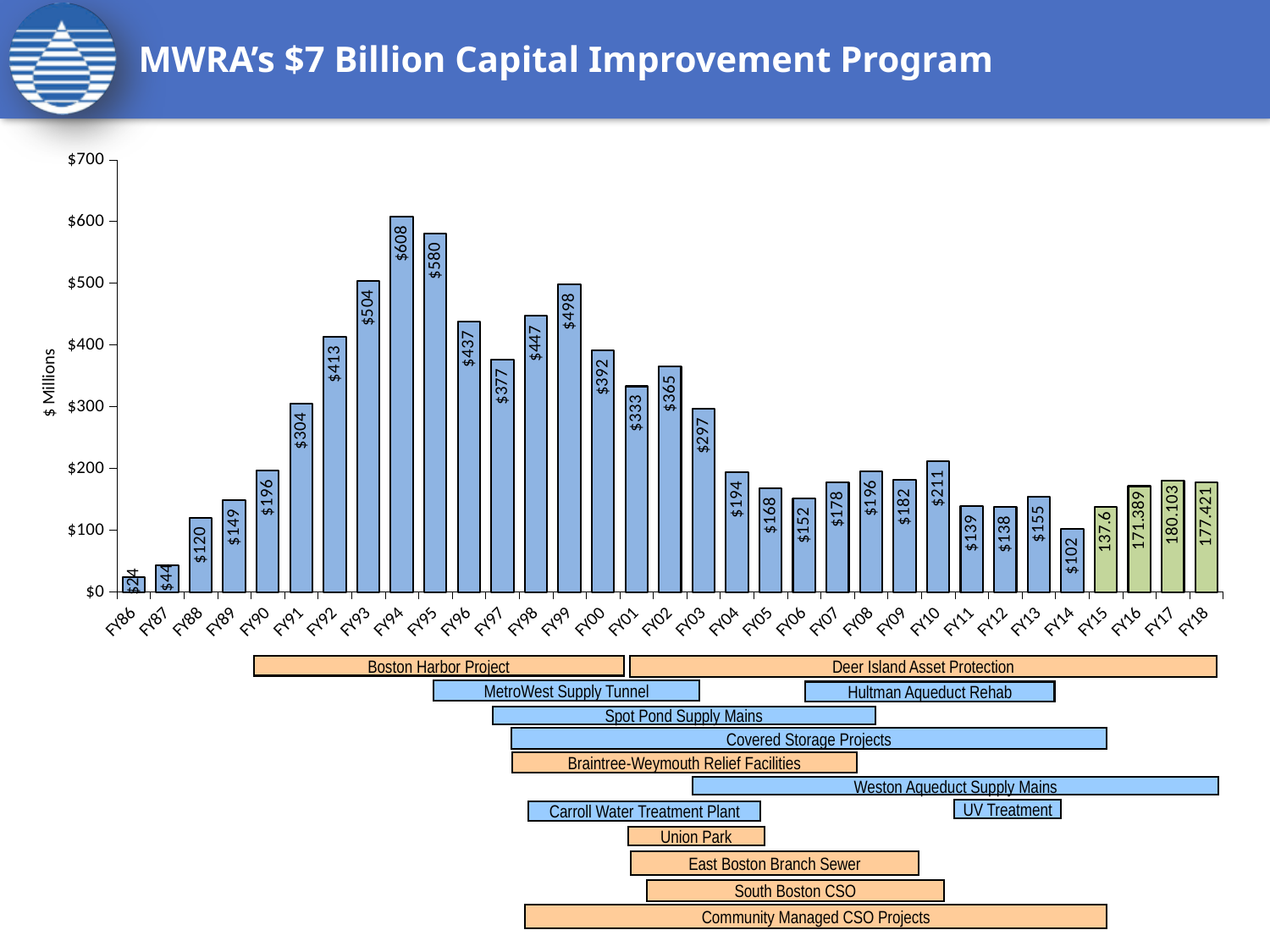
Which is larger, the value for FY02 or the value for FY01? FY02 What is the value for FY17? 180.103 Which fiscal year has the highest value? FY94 What is the difference between the values for FY93 and FY92? $91 Which fiscal year has the lowest value? FY86 What is the difference between the values for FY94 and FY95? $28 What is the value for FY94? $608 What kind of chart is shown on the slide? Bar chart What is the value for FY10? $211 How many fiscal years are shown on the x axis? 33 What is the label on the y axis? $ Millions Is the value for FY92 greater or less than $400? greater